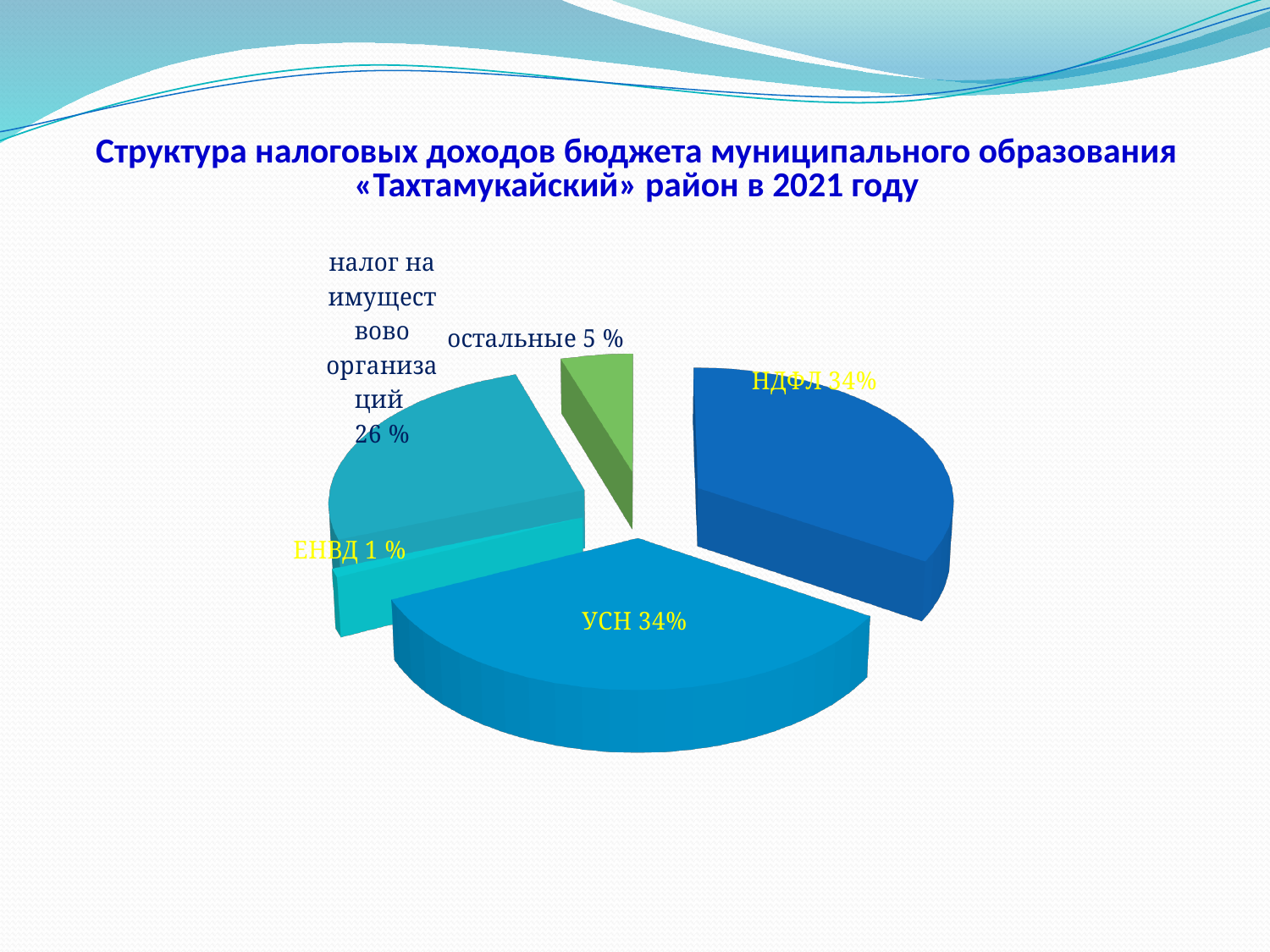
What share of the pie does НДФЛ account for? 34% By how many percentage points does the остальные slice exceed the ЕНВД slice? 4 What percentage is shown for ЕНВД? 1 % What percentage is shown for налог на имущество организаций? 26 % Which slice of the pie is the smallest? ЕНВД Which is larger: the share for УСН or the share for налог на имущество организаций? УСН What type of chart is shown on the slide? pie chart For which year does the chart show the structure of tax revenues? 2021 What percentage is shown for the остальные slice? 5 % How many slices does the pie chart have? 5 What share of the pie does УСН account for? 34% By how many percentage points does the share of НДФЛ exceed the share of налог на имущество организаций? 8